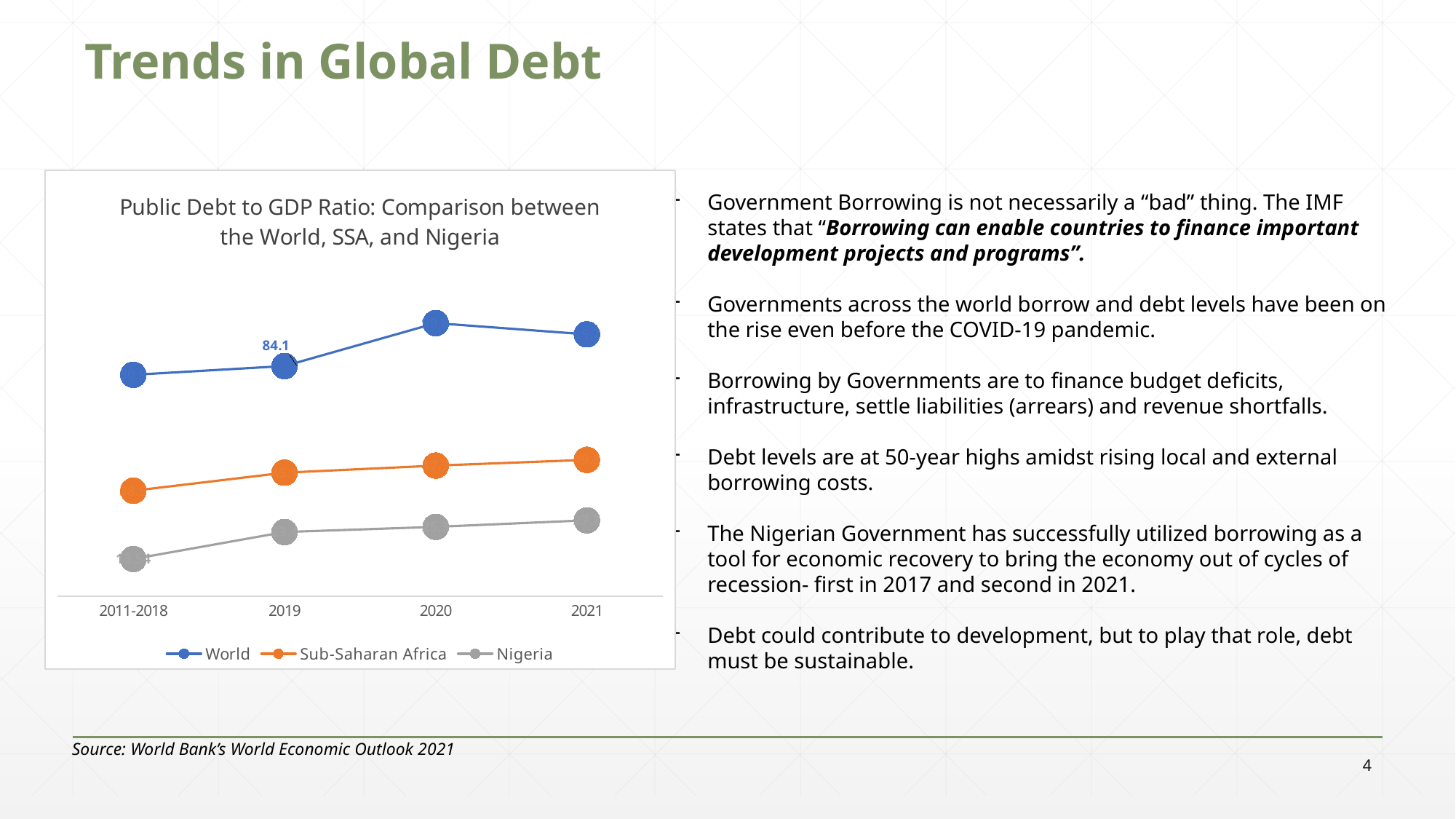
In 2021, which is larger: the Sub-Saharan Africa value or the Nigeria value? Sub-Saharan Africa Does the Sub-Saharan Africa series rise or fall from 2011-2018 to 2021? Rise How many points along the x axis does each series have? 4 Which series is drawn in orange? Sub-Saharan Africa In which period is the Nigeria series at its lowest? 2011-2018 In 2020, which is larger: the World value or the Nigeria value? World What kind of chart is shown on the slide? Line chart How many series does the chart's legend list? 3 What is the title of the chart? Public Debt to GDP Ratio: Comparison between the World, SSA, and Nigeria What is the World public debt to GDP ratio shown for 2019? 84.1 In which period is the World series at its highest? 2020 Does the World series rise or fall from 2020 to 2021? Fall